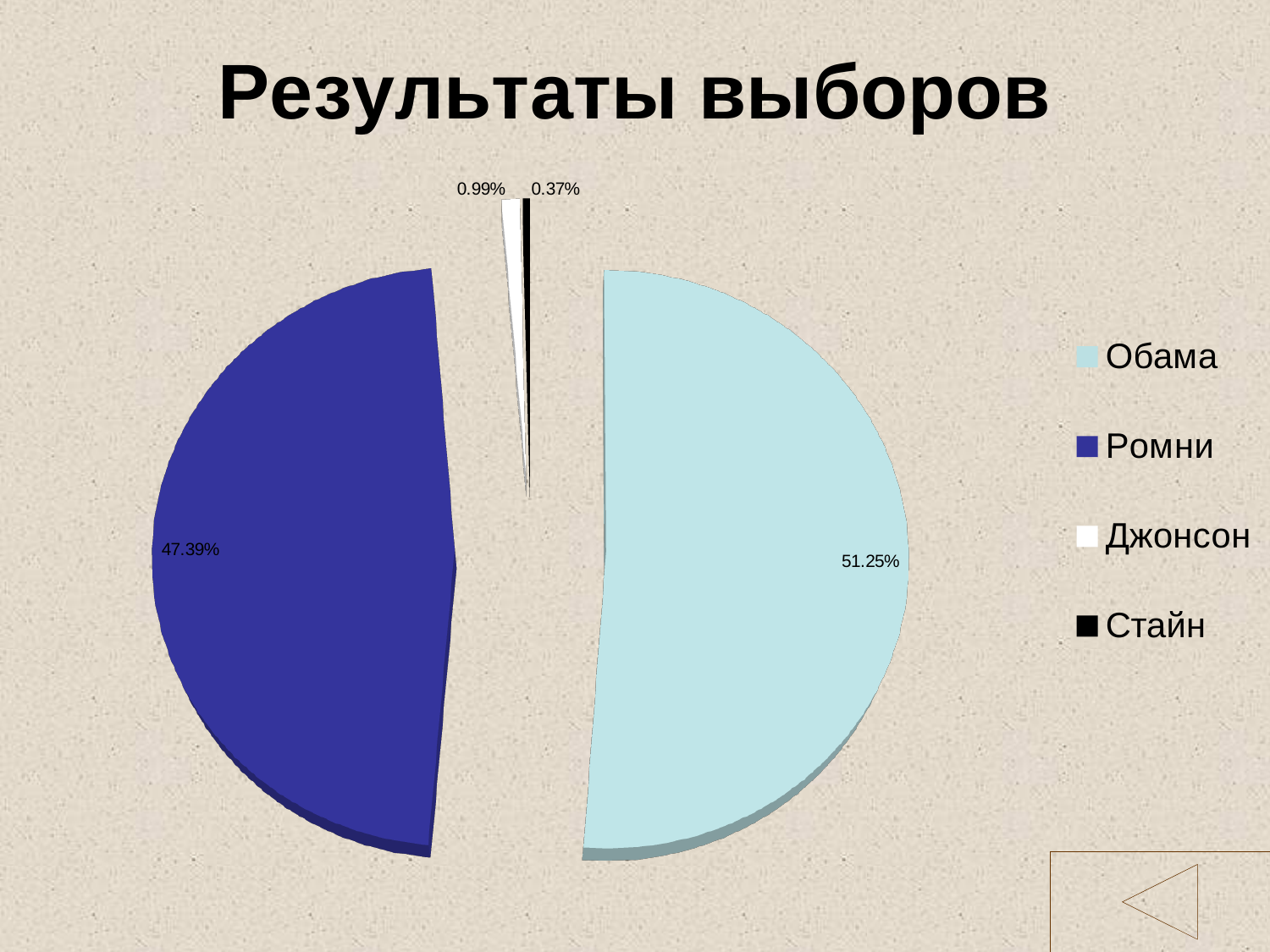
What is the value for Стайн? 0.37% What is the value for Ромни? 47.39% Which category has the smallest share of the pie? Стайн Which category has the largest share of the pie? Обама How many categories does the pie chart have? 4 What is the value for Джонсон? 0.99% What is the title of the slide? Результаты выборов Which colour represents Ромни in the legend? Dark blue What is the value for Обама? 51.25% What kind of chart is shown on the slide? Pie chart Which is larger, the value for Джонсон or the value for Стайн? Джонсон What is the difference between the values for Обама and Ромни? 3.86%